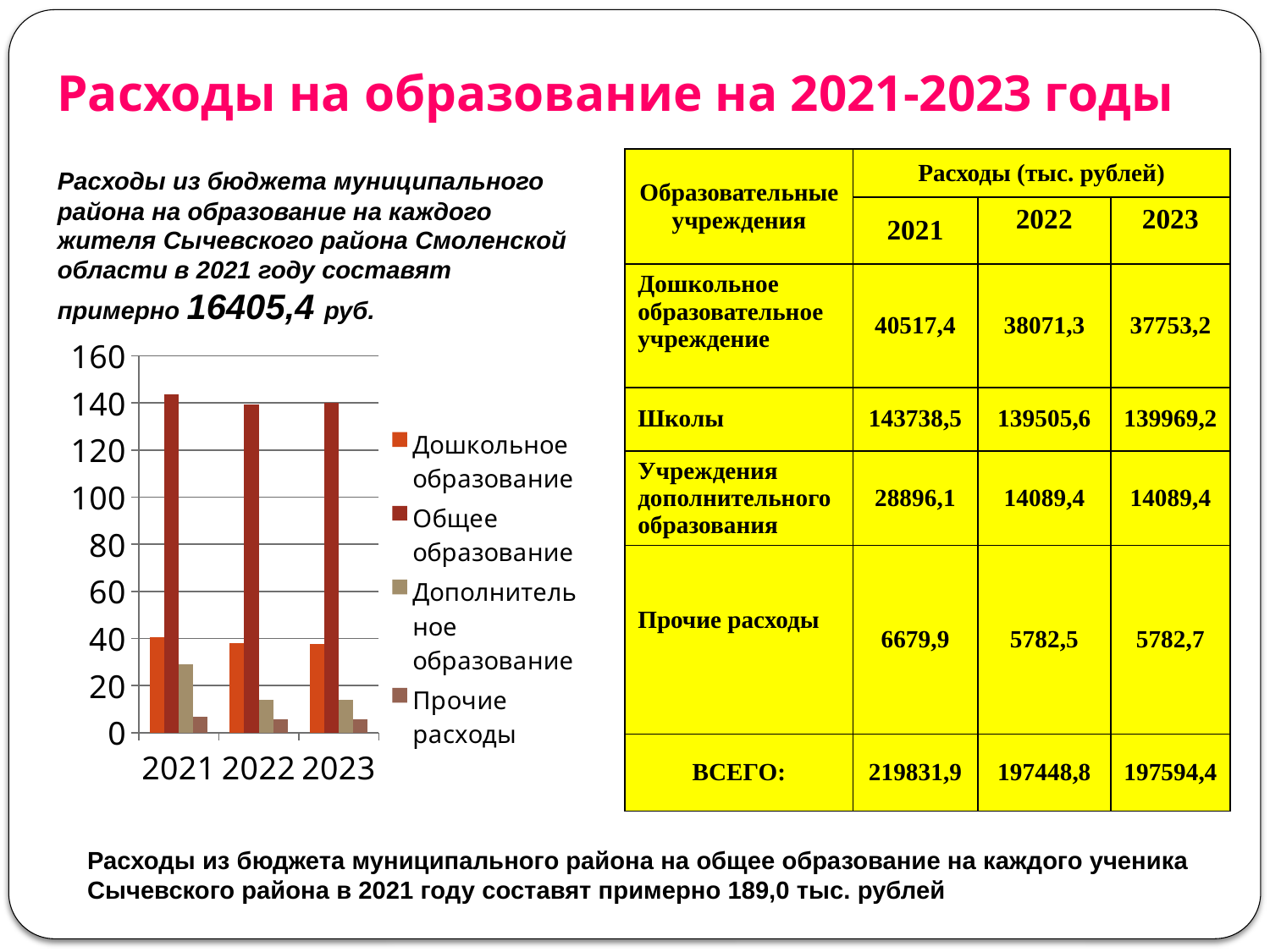
Which is larger in 2021: Дошкольное образование or Дополнительное образование? Дошкольное образование Is the value for Дошкольное образование in 2023 greater or less than 60? less Is the value for Прочие расходы in 2022 greater or less than 20? less How many years (categories) are shown on the x axis of the chart? 3 What kind of chart is shown on the slide? bar chart Which series has the shortest bar in 2023? Прочие расходы Is the value for Общее образование in 2021 greater or less than 140? greater Does the value for Дополнительное образование rise or fall from 2021 to 2022? fall How many series does the chart legend list? 4 Which series has the tallest bar in 2021? Общее образование Which series is shown in dark red in the chart legend? Общее образование